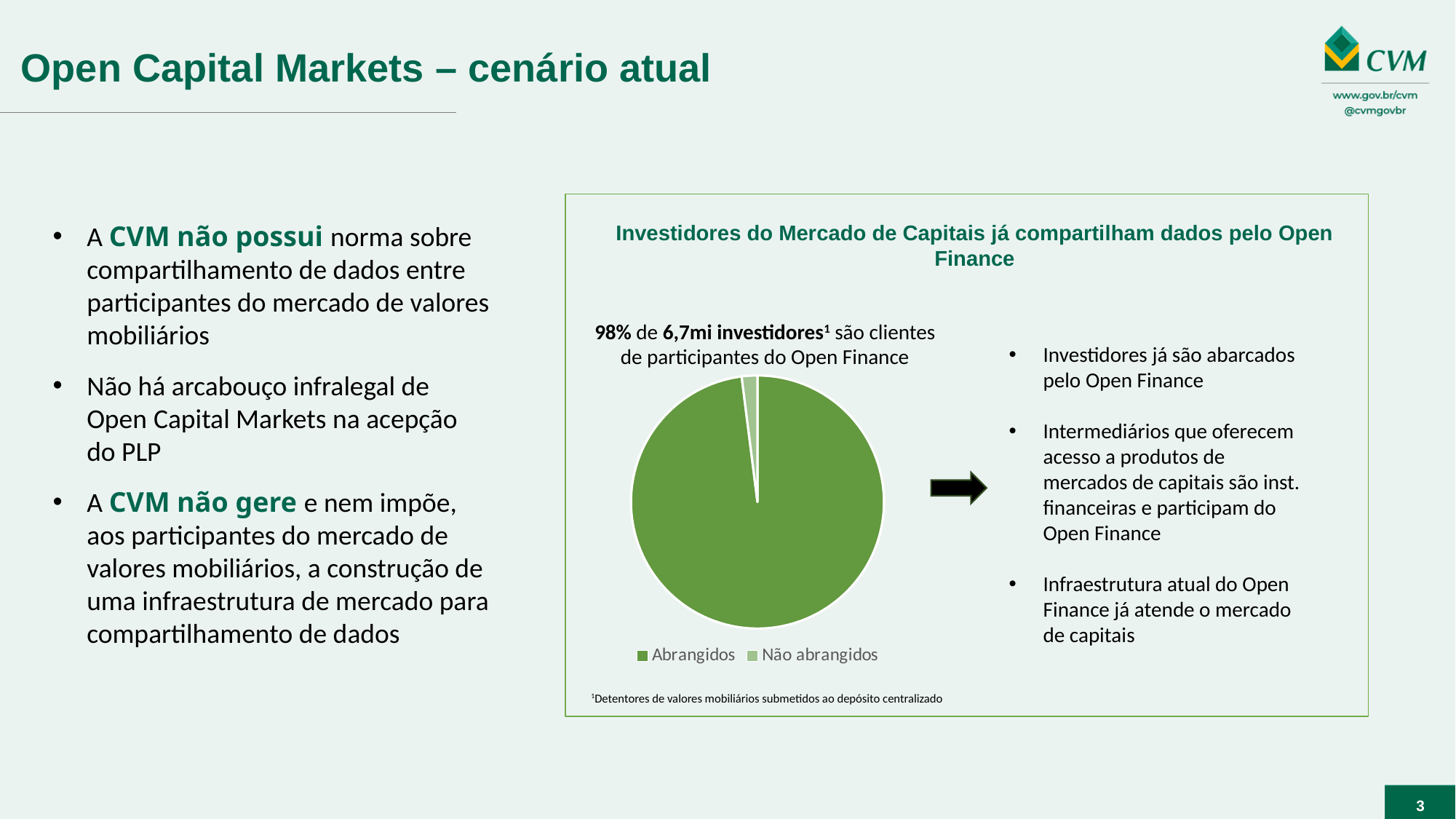
Which is larger in the pie chart, 'Abrangidos' or 'Não abrangidos'? Abrangidos Which slice of the pie chart is the largest? Abrangidos What share of the pie does the 'Abrangidos' slice represent? 98% What are the two legend entries of the pie chart? Abrangidos, Não abrangidos How many slices does the pie chart have? 2 What is the title of the chart box on the slide? Investidores do Mercado de Capitais já compartilham dados pelo Open Finance According to the text above the pie chart, how many investors are there in total? 6,7mi How many entries does the pie chart's legend list? 2 Which slice of the pie chart is the smallest? Não abrangidos What kind of chart is shown on the slide? pie chart What share of the pie does the 'Não abrangidos' slice represent? 2%